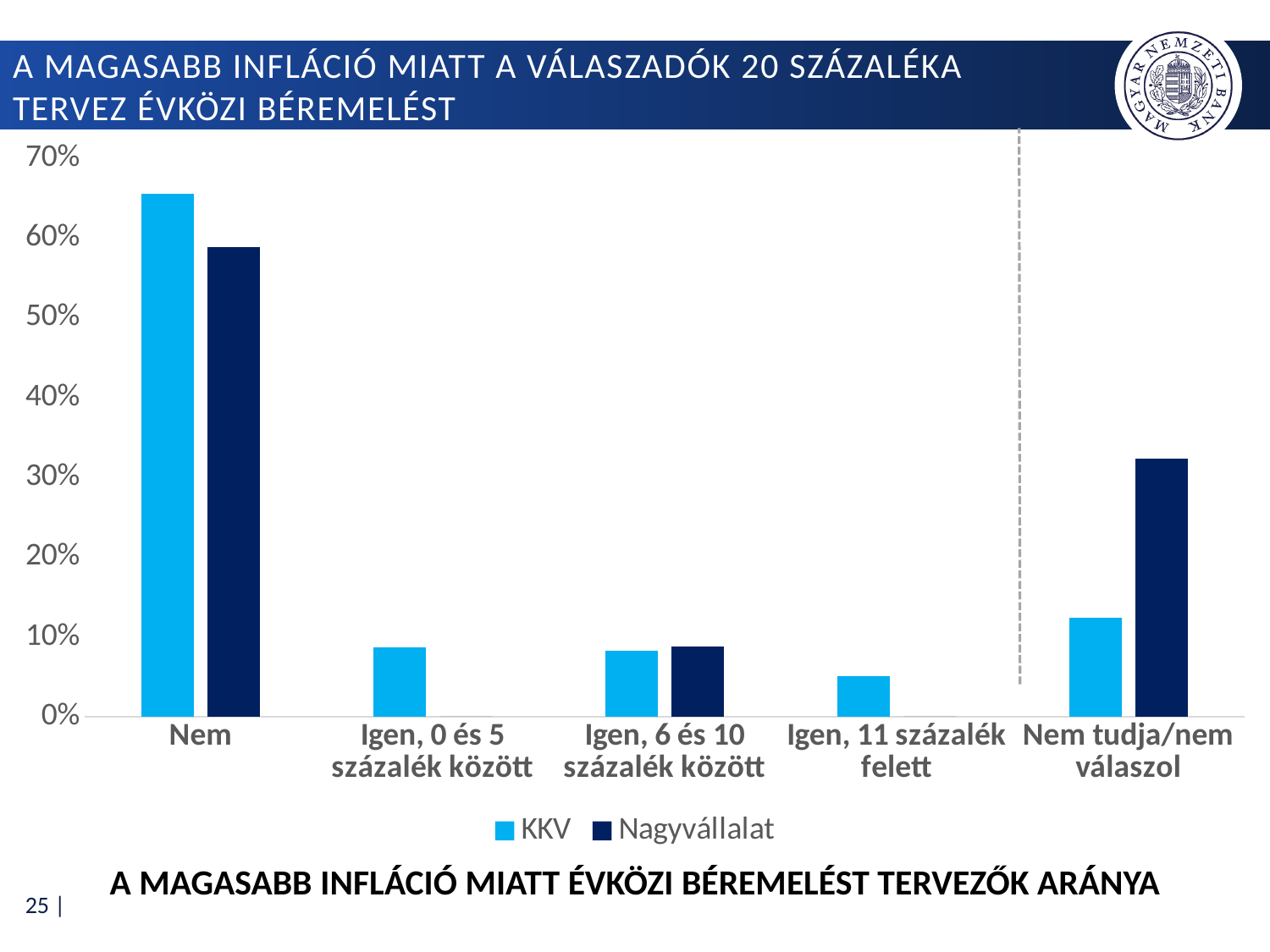
For the category 'Nem tudja/nem válaszol', which series has the larger value, KKV or Nagyvállalat? Nagyvállalat Which category has the lowest value for the KKV series? Igen, 11 százalék felett Which category has the highest value for the KKV series? Nem Is the KKV value for 'Nem' greater or less than 60%? greater Is the Nagyvállalat value for 'Nem tudja/nem válaszol' greater or less than 30%? greater How many categories are shown on the x axis? 5 What kind of chart is shown on the slide? bar chart For the category 'Nem', which series has the larger value, KKV or Nagyvállalat? KKV Is the KKV value for 'Igen, 0 és 5 százalék között' greater or less than 10%? less What are the two series named in the legend? KKV and Nagyvállalat Which category has the highest value for the Nagyvállalat series? Nem How many series does the legend list? 2